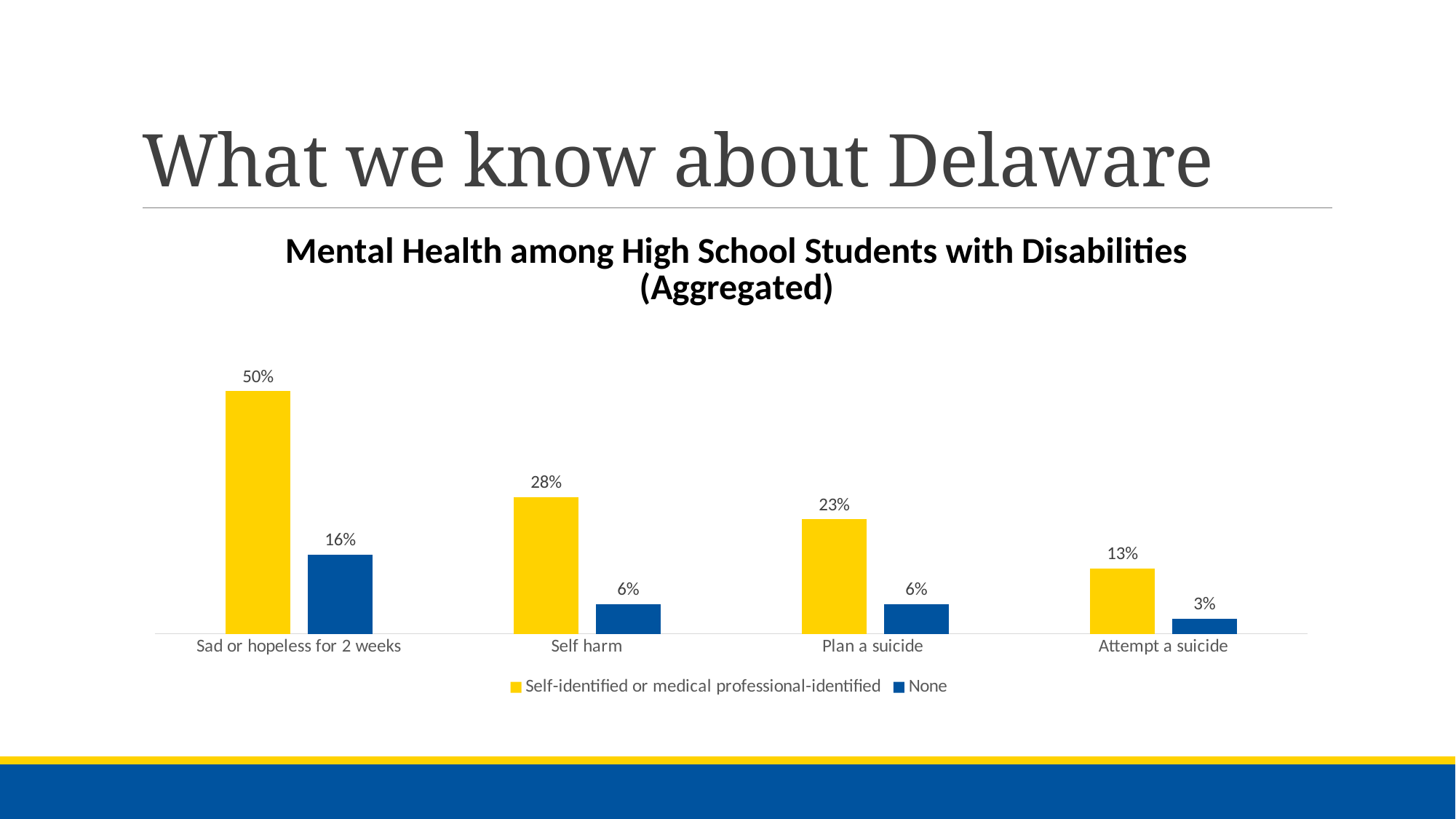
Which category has the lowest value for the 'None' series? Attempt a suicide What is the difference between the 'Self-identified or medical professional-identified' and 'None' values for 'Sad or hopeless for 2 weeks'? 34% What is the value for 'Self-identified or medical professional-identified' in the 'Sad or hopeless for 2 weeks' category? 50% What is the value for 'Self-identified or medical professional-identified' in the 'Self harm' category? 28% Which category has the highest value for the 'Self-identified or medical professional-identified' series? Sad or hopeless for 2 weeks What kind of chart is shown on the slide? Bar chart What is the difference between the 'Self-identified or medical professional-identified' values for 'Plan a suicide' and 'Attempt a suicide'? 10% Which is larger: the 'None' value for 'Sad or hopeless for 2 weeks' or the 'Self-identified or medical professional-identified' value for 'Attempt a suicide'? None value for Sad or hopeless for 2 weeks What is the value for 'None' in the 'Plan a suicide' category? 6% How many series does the legend list? 2 How many categories are shown on the x axis? 4 What is the value for 'None' in the 'Attempt a suicide' category? 3%